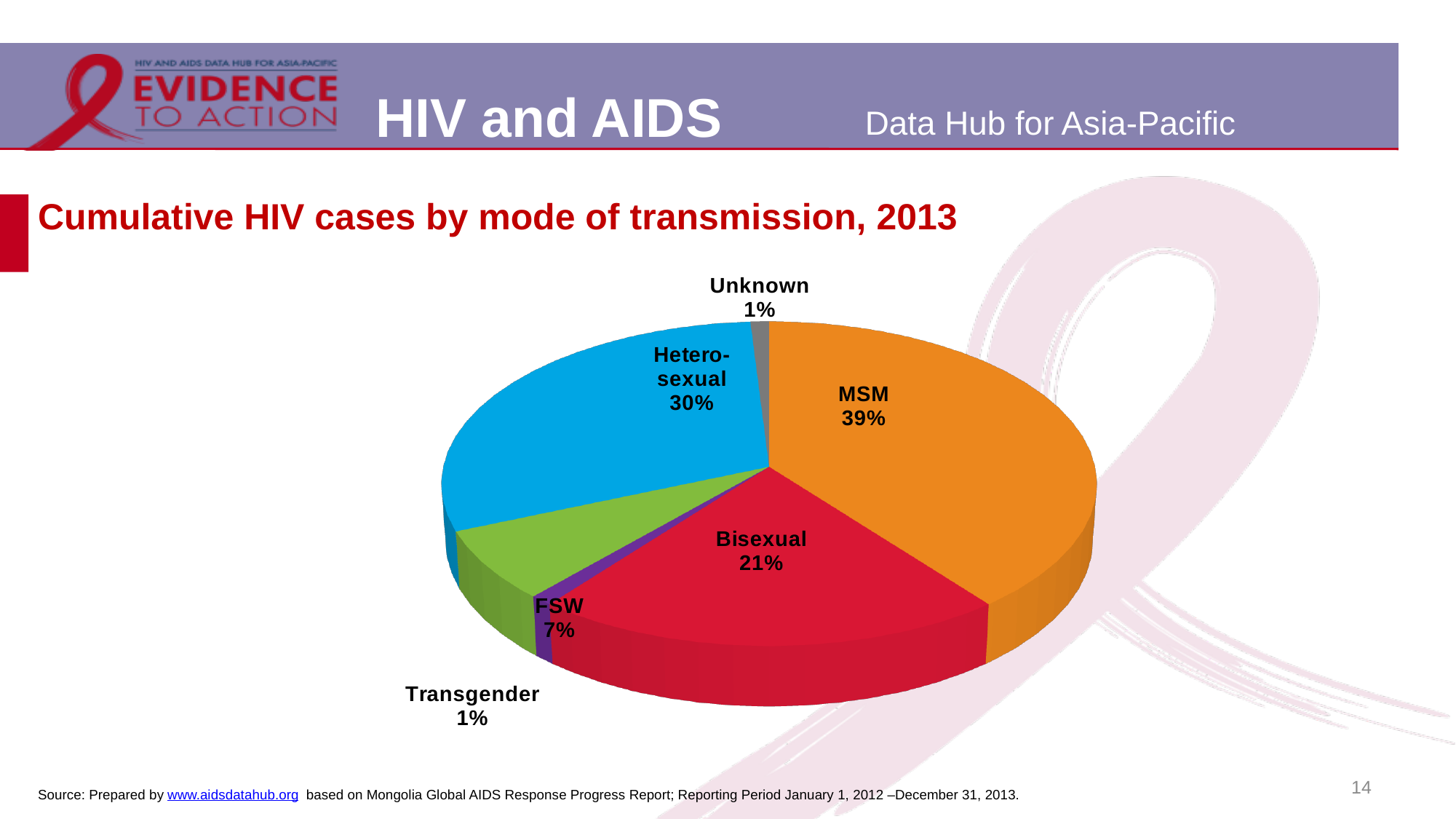
What kind of chart is shown on the slide? pie chart What share of cumulative HIV cases is attributed to bisexual transmission? 21% What share of cumulative HIV cases is attributed to FSW? 7% What share of cumulative HIV cases is attributed to MSM? 39% Which is larger, the bisexual share or the FSW share? Bisexual What is the difference in percentage points between the MSM and heterosexual shares? 9 percentage points How many slices does the pie chart have? 6 Which mode of transmission accounts for the largest share of cumulative HIV cases? MSM What is the title of the chart? Cumulative HIV cases by mode of transmission, 2013 What colour is the MSM slice? orange